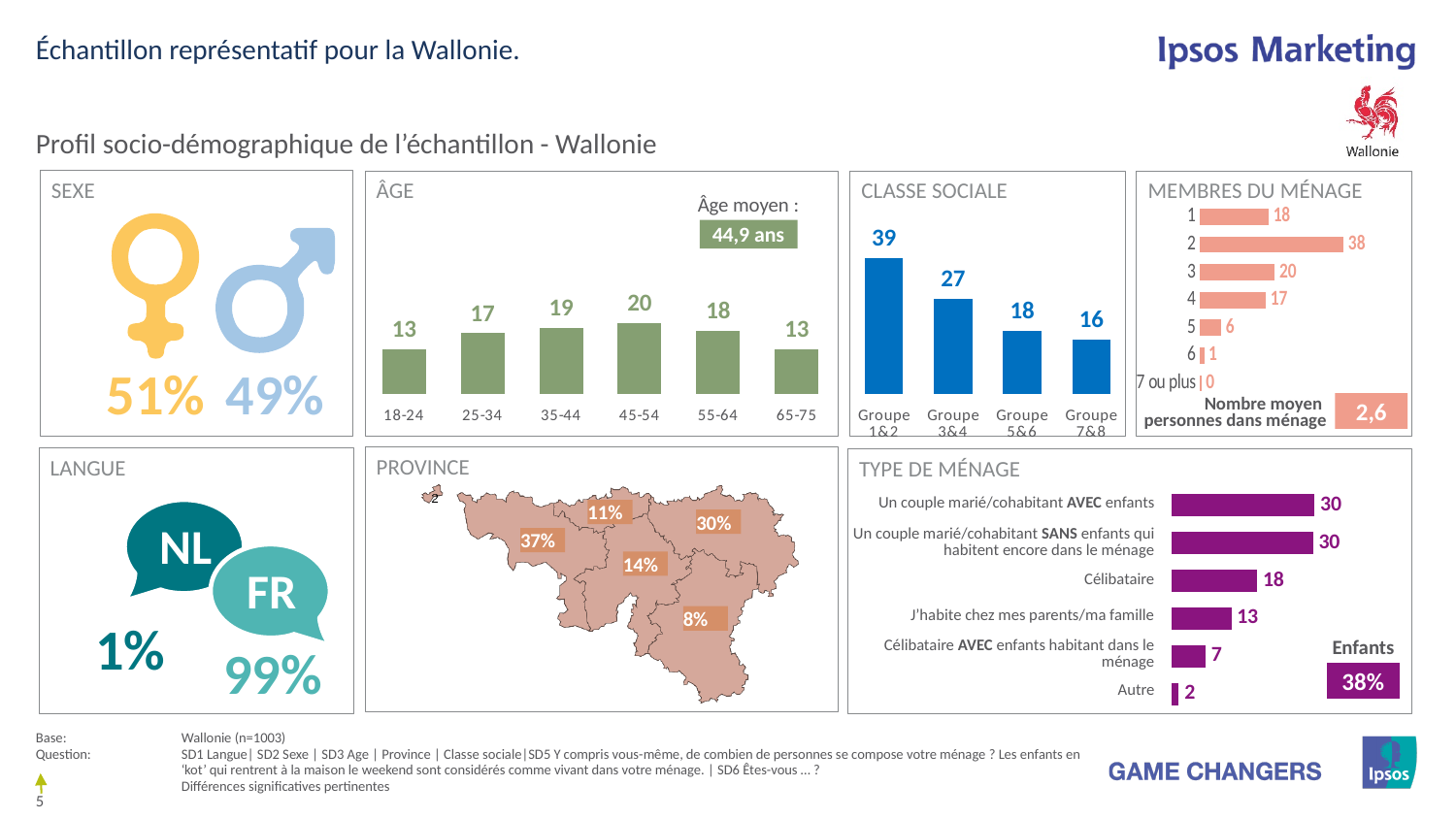
In the ÂGE chart, which age group has the highest value? 45-54 In the ÂGE chart, how many age groups are shown? 6 In the TYPE DE MÉNAGE chart, which is larger: J'habite chez mes parents/ma famille or Célibataire AVEC enfants habitant dans le ménage? J'habite chez mes parents/ma famille In the MEMBRES DU MÉNAGE chart, what is the value for households of 2 members? 38 In the TYPE DE MÉNAGE chart, what is the value for Célibataire? 18 In the CLASSE SOCIALE chart, what is the value for Groupe 3&4? 27 In the ÂGE chart, what is the value for the 45-54 age group? 20 In the CLASSE SOCIALE chart, what kind of chart is used? Bar chart In the CLASSE SOCIALE chart, which group has the lowest value? Groupe 7&8 In the ÂGE chart, what is the difference between the values for 35-44 and 18-24? 6 In the TYPE DE MÉNAGE chart, how many categories are shown? 6 In the MEMBRES DU MÉNAGE chart, which household size has the highest value? 2